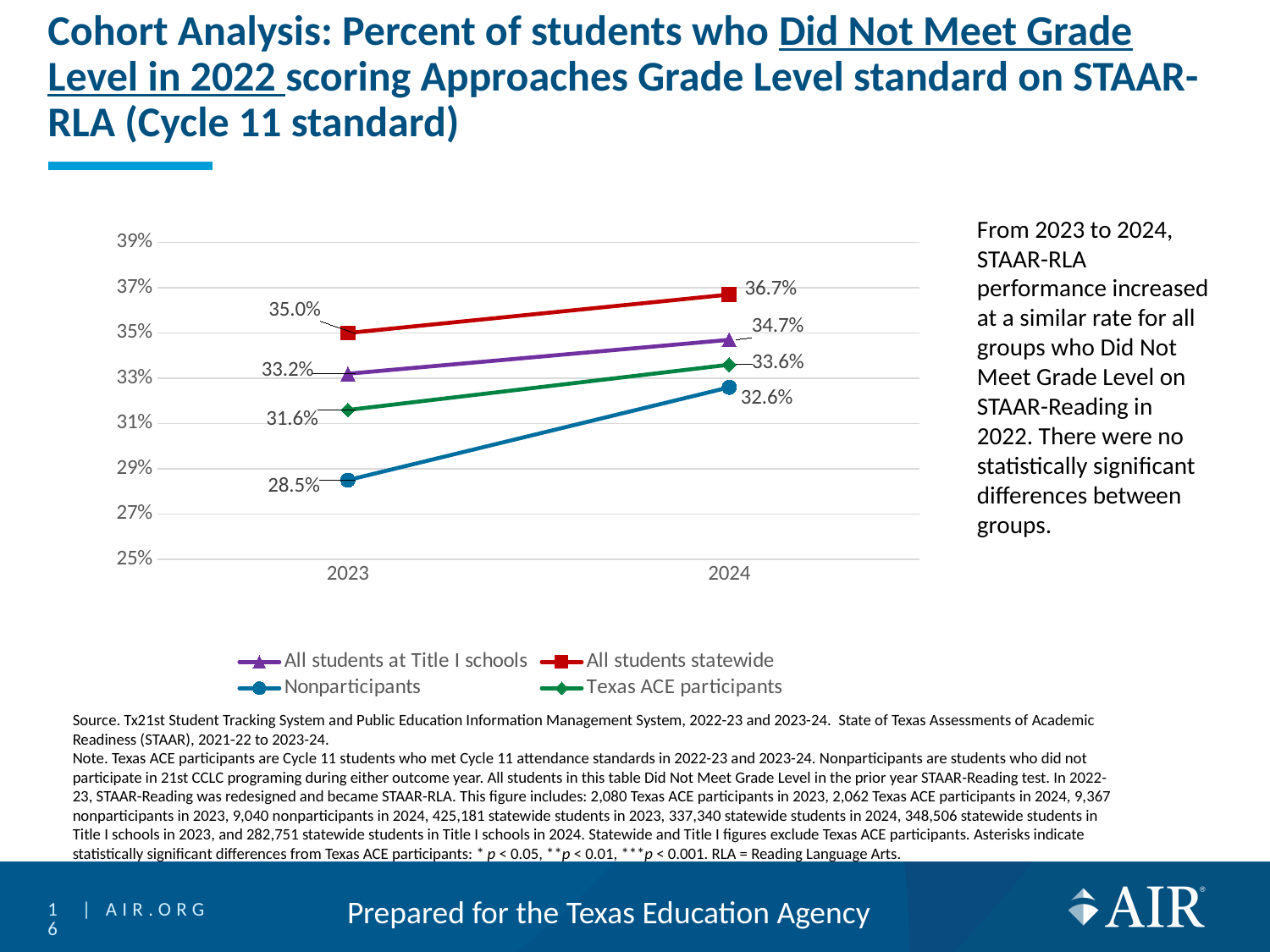
How many years are shown on the x axis? 2 What was the value for All students at Title I schools in 2023? 33.2% Did the value for Texas ACE participants rise or fall from 2023 to 2024? Rise Which group had the highest value in 2024? All students statewide What was the value for Texas ACE participants in 2024? 33.6% What kind of chart is shown on the slide? Line chart Which was larger in 2024, the value for Texas ACE participants or the value for Nonparticipants? Texas ACE participants What was the value for Nonparticipants in 2023? 28.5% How many series does the legend list? 4 Which group had the lowest value in 2023? Nonparticipants By how many percentage points did the Nonparticipants value change from 2023 to 2024? 4.1 percentage points What was the value for All students statewide in 2024? 36.7%